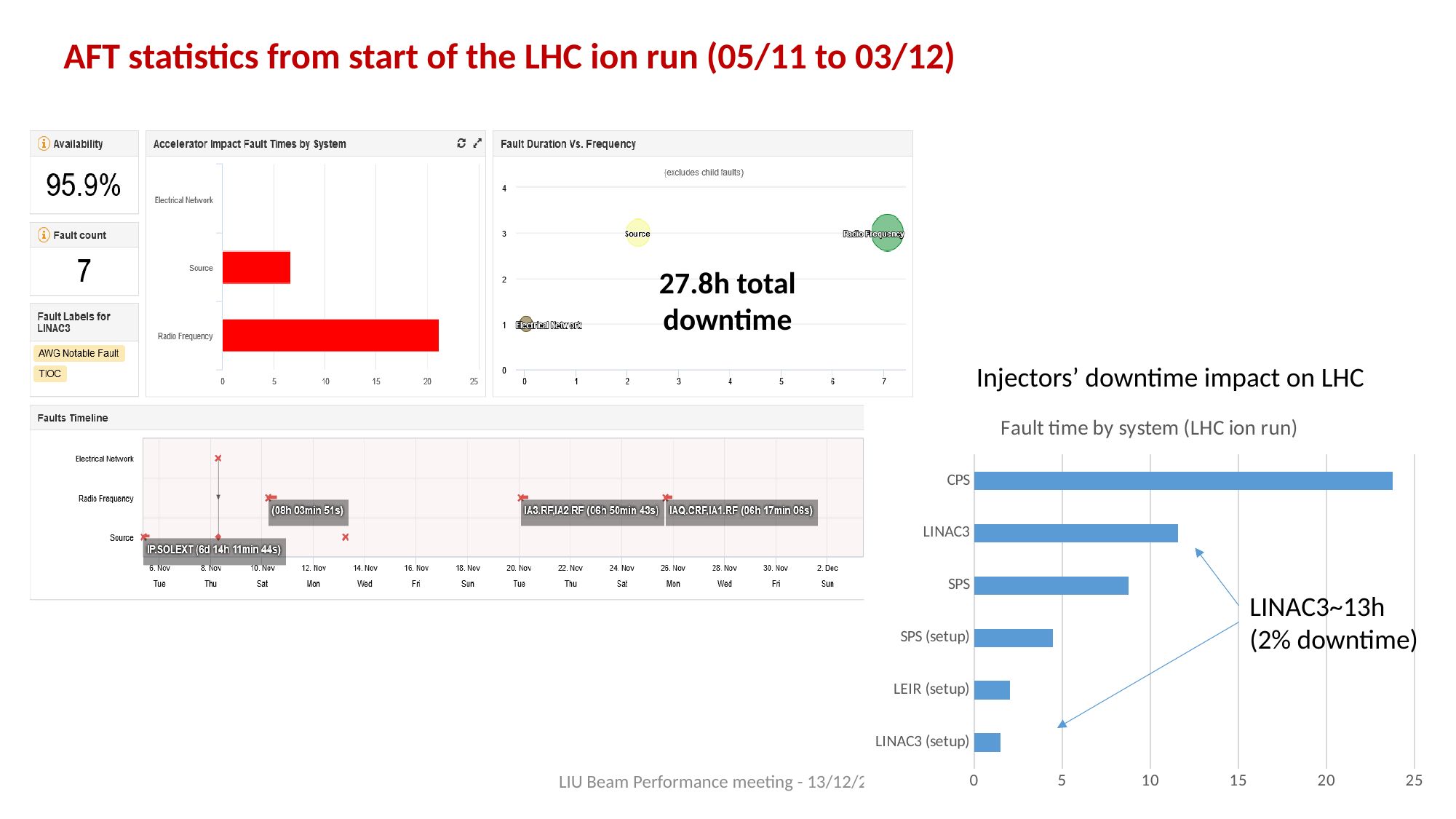
In the 'Accelerator Impact Fault Times by System' chart, which system has the highest fault time? Radio Frequency In the 'Fault Duration Vs. Frequency' chart, what is the frequency (y-axis value) for Electrical Network? 1 In the 'Fault time by system (LHC ion run)' chart, which system has the highest fault time? CPS In the 'Fault time by system (LHC ion run)' chart, is the value for LINAC3 greater or less than 10? greater In the 'Fault time by system (LHC ion run)' chart, which is larger, the value for SPS or the value for SPS (setup)? SPS In the 'Accelerator Impact Fault Times by System' chart, is the value for Source greater or less than 10? less What kind of chart is 'Fault time by system (LHC ion run)'? Bar chart What availability value is shown in the Availability tile on the slide? 95.9% In the 'Fault time by system (LHC ion run)' chart, is the value for SPS greater or less than 10? less In the 'Fault time by system (LHC ion run)' chart, how many systems are listed on the vertical axis? 6